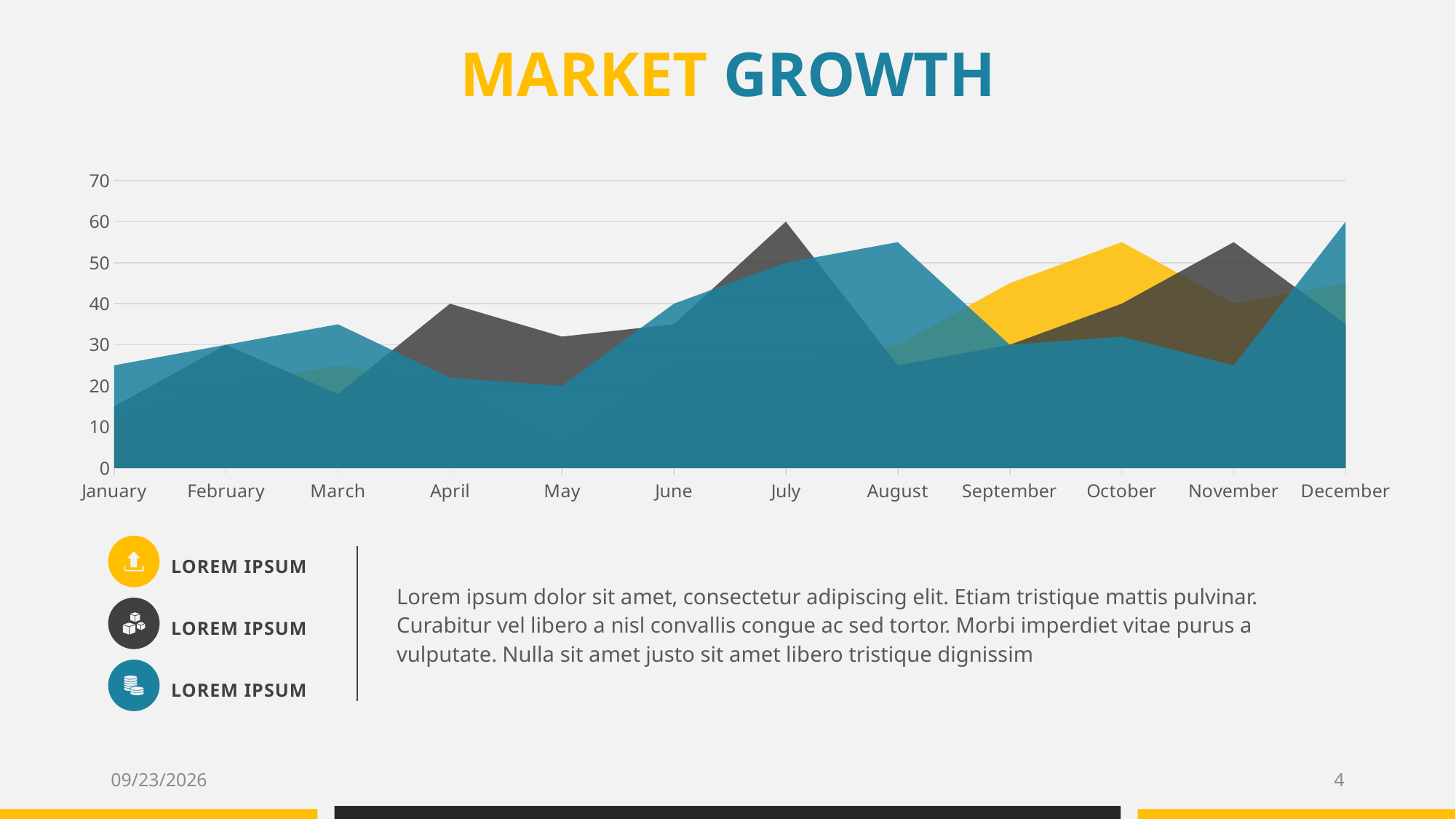
How many series are plotted in the chart? 3 Is the yellow series value for October greater or less than 50? greater What is the title of the slide containing the chart? MARKET GROWTH Is the dark gray series value for July greater or less than 50? greater What kind of chart is shown on the slide? Area chart What is the highest value shown on the y axis of the chart? 70 How many months are shown along the x axis of the chart? 12 Is the teal series value for December greater or less than 50? greater In which month does the yellow series reach its highest value? October In which month does the dark gray series reach its highest value? July